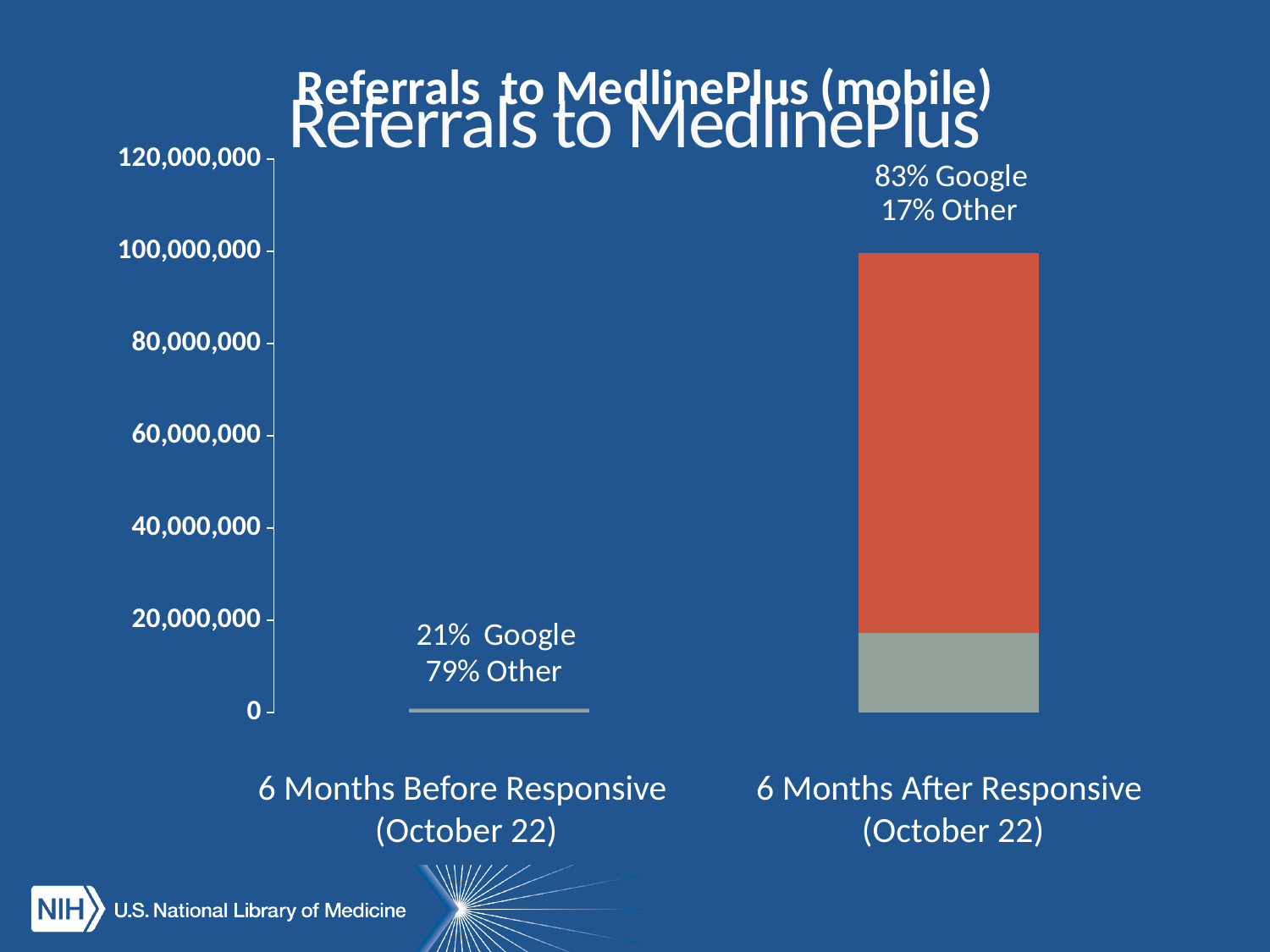
Which is larger: the Google share 6 Months Before Responsive or the Google share 6 Months After Responsive? 6 Months After Responsive What percentage of referrals came from Google in the 6 Months Before Responsive (October 22)? 21% Is the total value for 6 Months After Responsive (October 22) greater or less than 80,000,000? greater How many categories are shown on the x axis of the chart? 2 What kind of chart is shown on the slide? Stacked bar chart What is the highest value labelled on the y axis of the chart? 120,000,000 What percentage of referrals came from Other sources in the 6 Months Before Responsive (October 22)? 79% Which category has the lowest total referrals? 6 Months Before Responsive (October 22) What percentage of referrals came from Google in the 6 Months After Responsive (October 22)? 83% What colour is the Google segment of the 6 Months After Responsive bar? Red Which category has the highest total referrals? 6 Months After Responsive (October 22) Is the total value for 6 Months Before Responsive (October 22) greater or less than 20,000,000? less